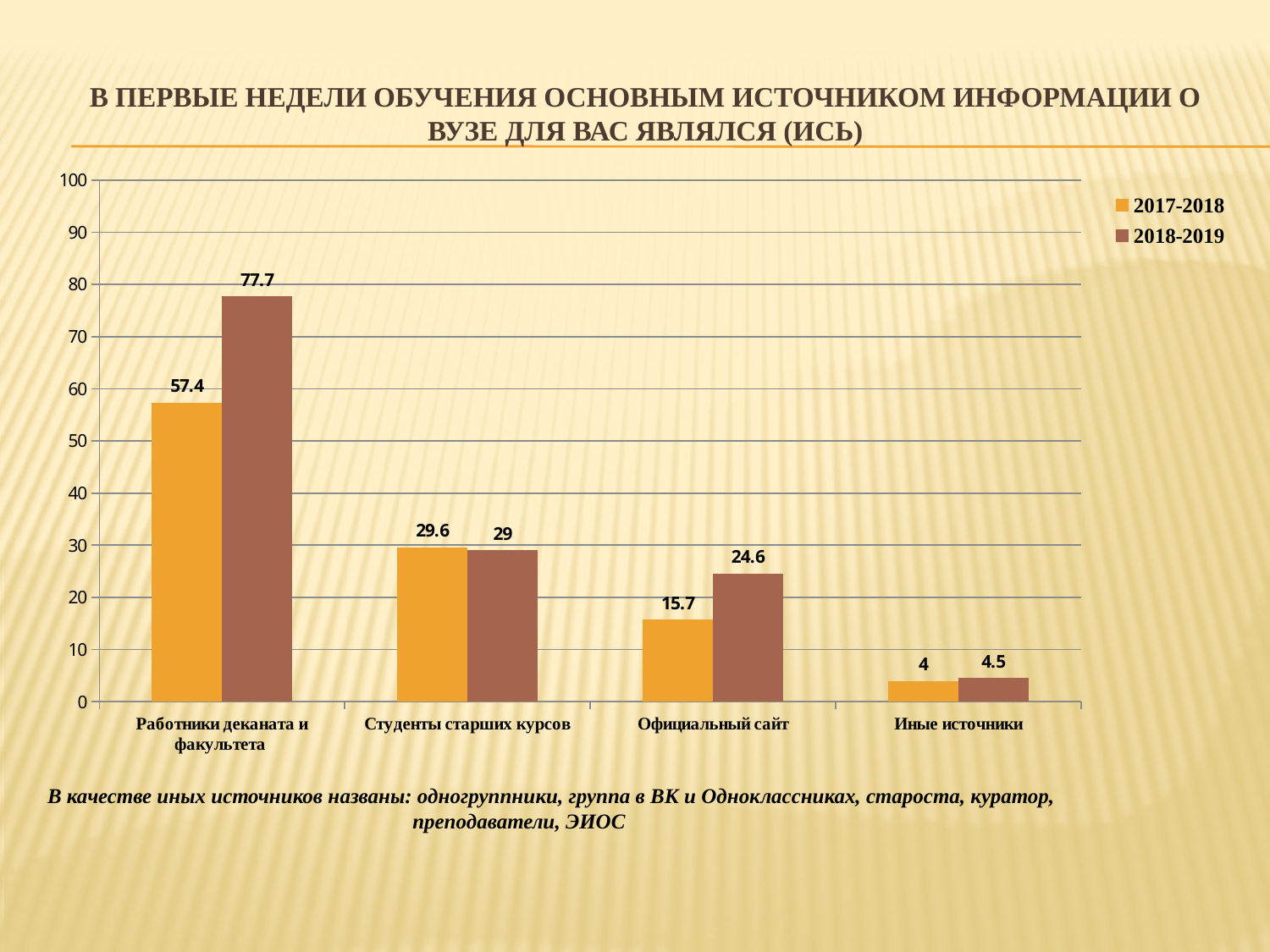
What kind of chart is shown on the slide? Bar chart Which category has the highest value in the 2017-2018 series? Работники деканата и факультета What is the difference between the 2018-2019 and 2017-2018 values for Официальный сайт? 8.9 What is the value for Работники деканата и факультета in the 2018-2019 series? 77.7 How many series does the legend list? 2 How many categories are shown on the x axis? 4 Which colour represents the 2017-2018 series in the legend? Orange Which is larger for Студенты старших курсов: the 2017-2018 value or the 2018-2019 value? 2017-2018 What is the value for Иные источники in the 2018-2019 series? 4.5 What is the value for Официальный сайт in the 2017-2018 series? 15.7 What is the difference between the 2018-2019 and 2017-2018 values for Работники деканата и факультета? 20.3 Which category has the lowest value in the 2018-2019 series? Иные источники